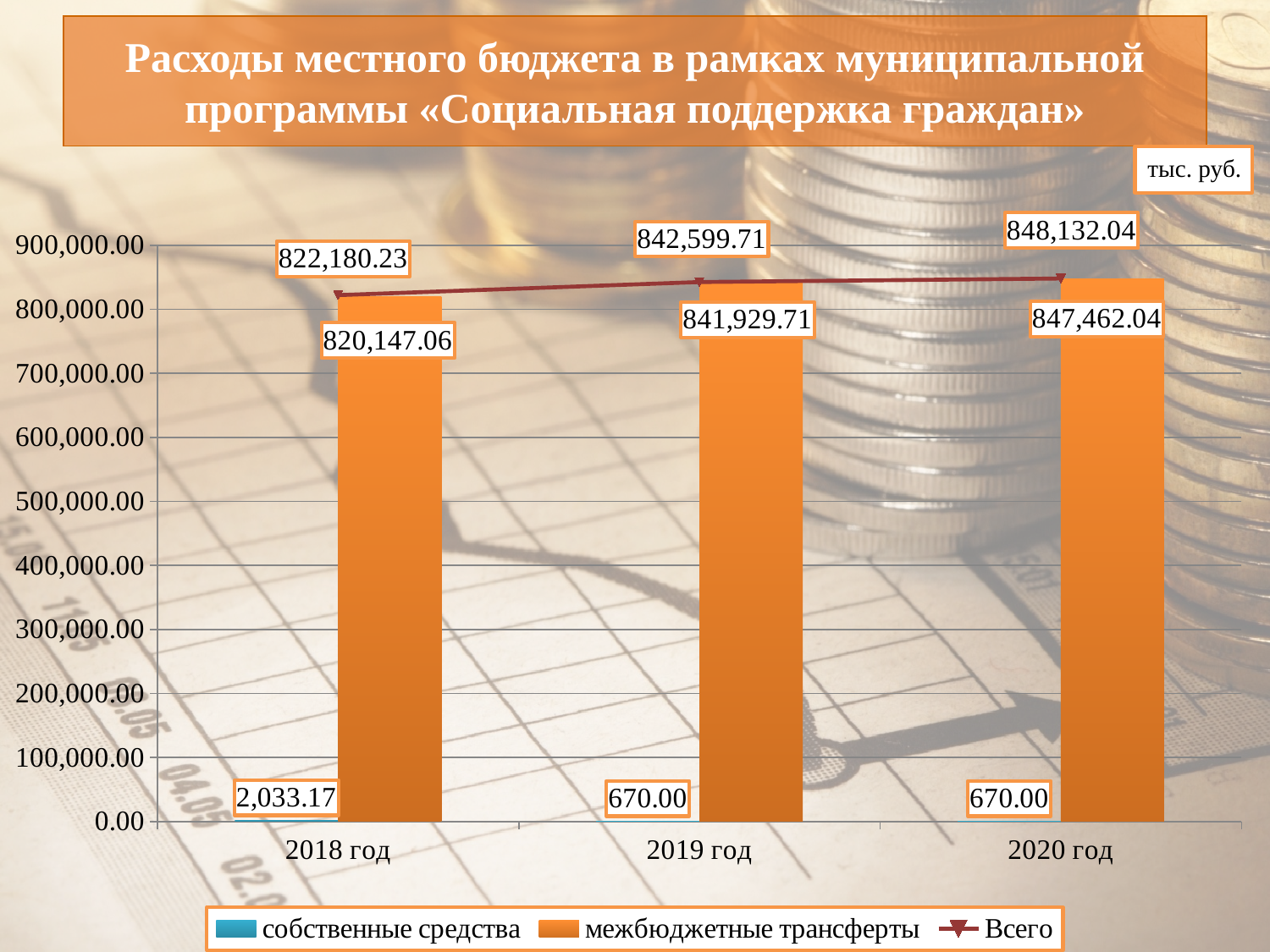
Which is larger: межбюджетные трансферты for 2019 год or for 2018 год? 2019 год Does the Всего line rise or fall from 2018 год to 2020 год? rises What is the difference between the Всего values for 2020 год and 2018 год? 25,951.81 In which year is the Всего value the highest? 2020 год What is the Всего value for 2020 год? 848,132.04 How many series does the legend list? 3 What is the difference between the межбюджетные трансферты values for 2020 год and 2019 год? 5,532.33 What is the value of собственные средства for 2018 год? 2,033.17 In which year is the value of собственные средства the highest? 2018 год What is the value of межбюджетные трансферты for 2019 год? 841,929.71 How many years are shown on the x axis? 3 What is the value of межбюджетные трансферты for 2018 год? 820,147.06